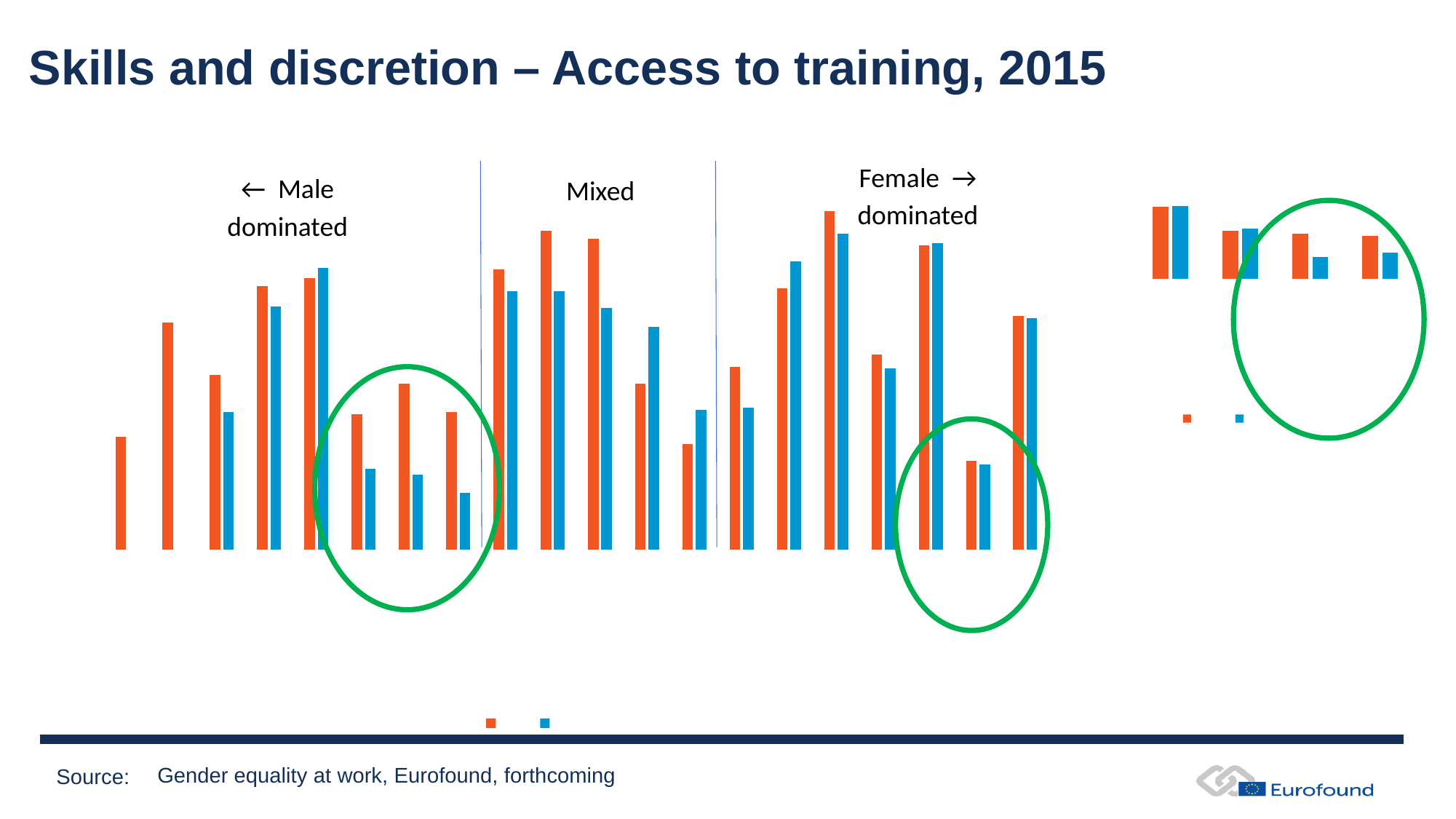
How many pairs of bars are in the Mixed section of the main chart? 5 What two colours are used for the bars in the chart? orange and blue How many series does the legend of the chart show? 2 In the first pair of bars in the Female dominated section of the main chart, which bar is taller, the orange one or the blue one? orange What kind of chart is shown on the slide? bar chart Into how many labelled sections (Male dominated, Mixed, Female dominated) is the main chart divided? 3 In the second pair of bars in the Mixed section of the main chart, which bar is taller, the orange one or the blue one? orange What is the title of the slide containing the chart? Skills and discretion – Access to training, 2015